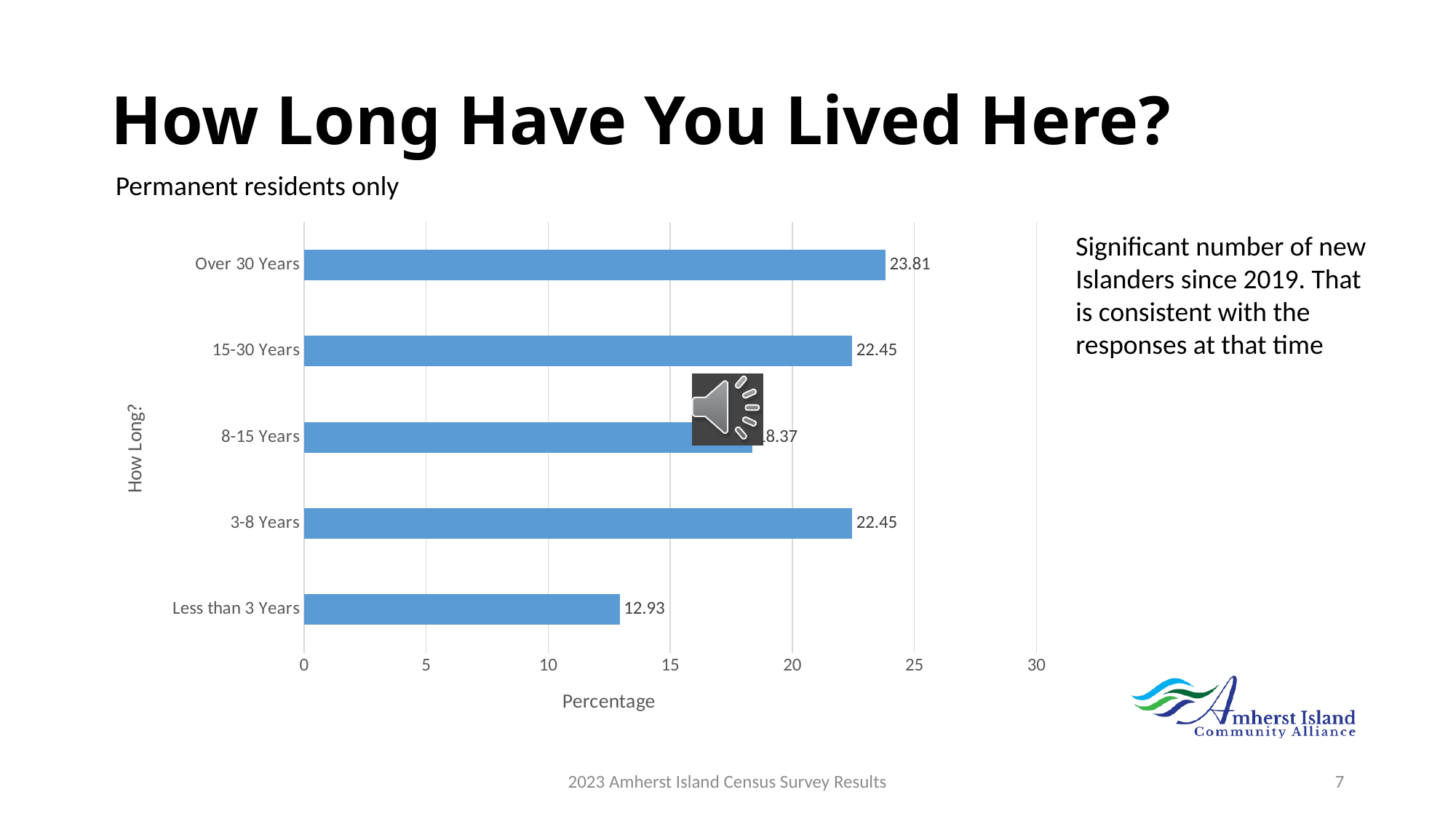
What is the value for Over 30 Years? 23.81 What is the difference between the values for Over 30 Years and Less than 3 Years? 10.88 What is the value for 15-30 Years? 22.45 How many categories are shown in the chart? 5 What is the value for 3-8 Years? 22.45 Which category has the highest value? Over 30 Years What is the title of the horizontal axis? Percentage Which is larger, the value for Over 30 Years or the value for 3-8 Years? Over 30 Years Which category has the lowest value? Less than 3 Years What is the value for Less than 3 Years? 12.93 What kind of chart is shown on the slide? bar chart Is the value for 8-15 Years greater or less than 20? less